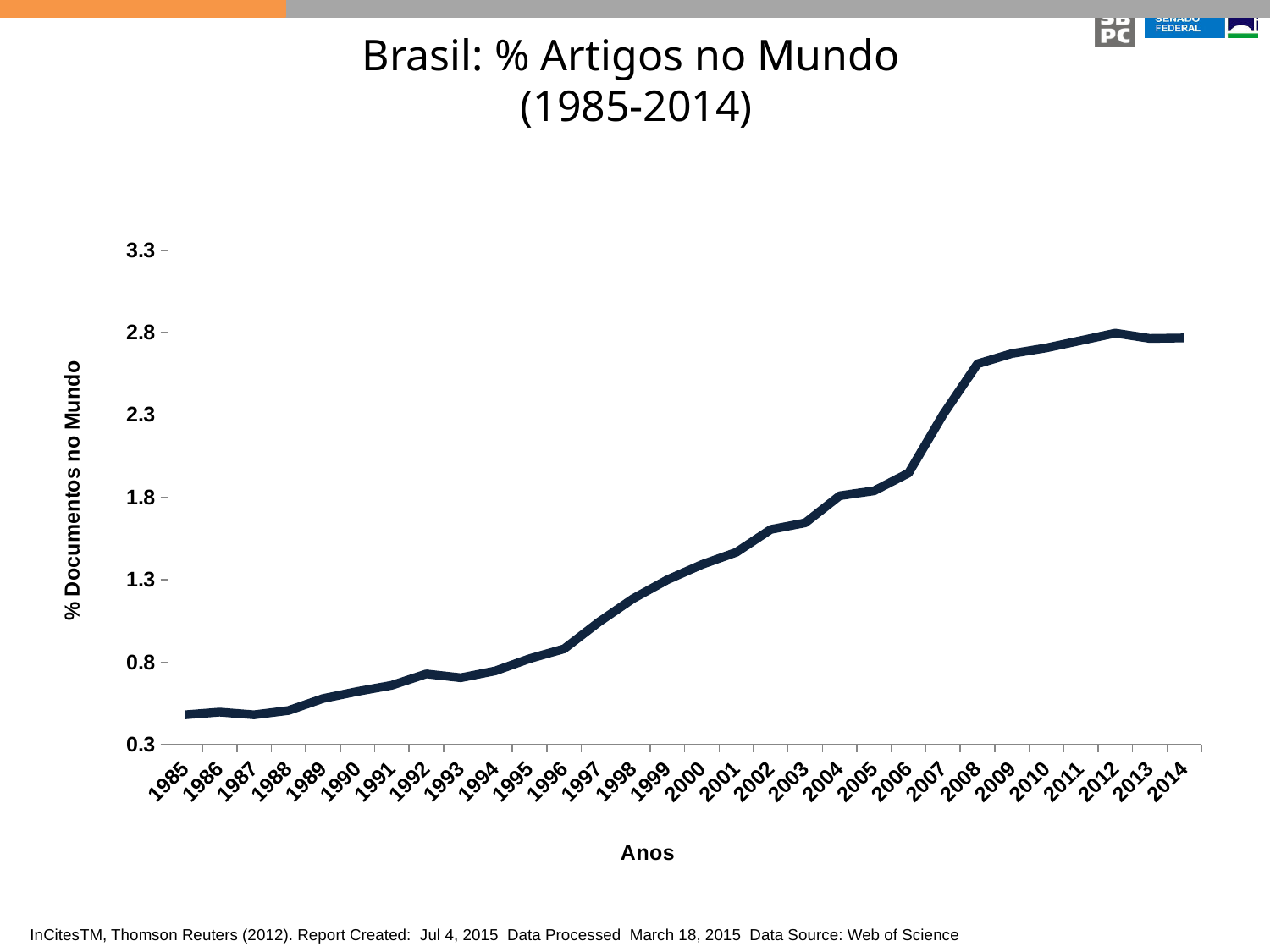
Is the value for 2014 greater or less than 2.3? greater Is the value for 2003 greater or less than 1.8? less What kind of chart is shown on the slide? line chart Is the value for 1993 greater or less than 0.8? less How many years are plotted along the x axis? 30 Which year has the larger value, 1990 or 2010? 2010 Does the percentage of Brazilian articles in the world generally rise or fall from 1985 to 2014? rise What is the title of the chart? Brasil: % Artigos no Mundo (1985-2014) What is the label of the y axis? % Documentos no Mundo